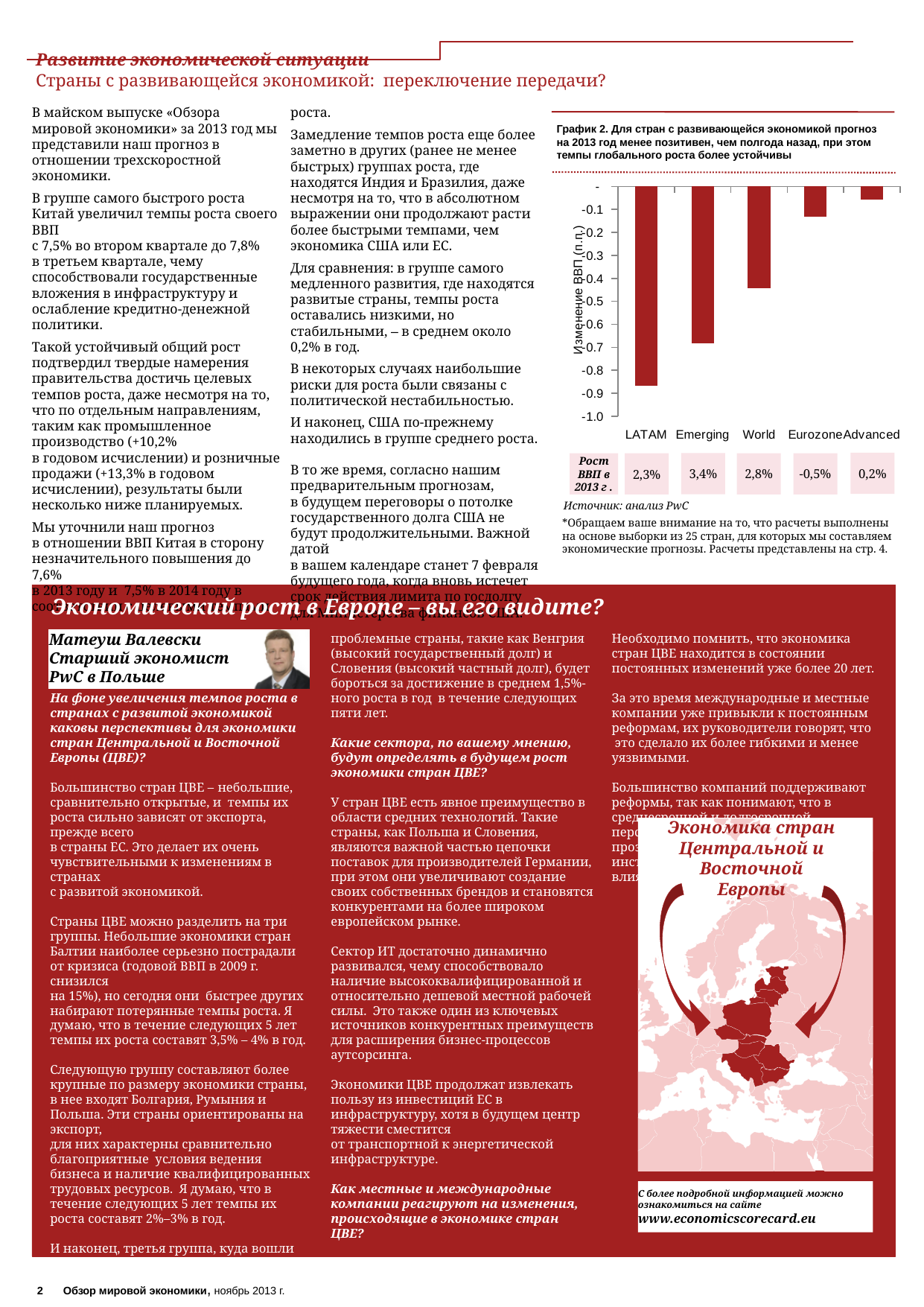
Is the value for Eurozone in the chart greater or less than -0.2? greater Is the value for World in the chart greater or less than -0.5? greater Is the value for LATAM in the chart greater or less than -0.8? less What kind of chart is shown in График 2? bar chart How many categories are plotted on the x axis of the chart in График 2? 5 Which category in the chart has the smallest downward revision (the shortest bar)? Advanced According to the row 'Рост ВВП в 2013 г.' under the chart, what is the 2013 GDP growth for Emerging? 3,4% What is the label on the vertical axis of the chart in График 2? Изменение ВВП (п.п.) According to the row 'Рост ВВП в 2013 г.' under the chart, what is the 2013 GDP growth for Eurozone? -0,5% Which bar extends further below zero in the chart, Emerging or World? Emerging Which category in the chart has the largest downward revision (the bar extending furthest below zero)? LATAM